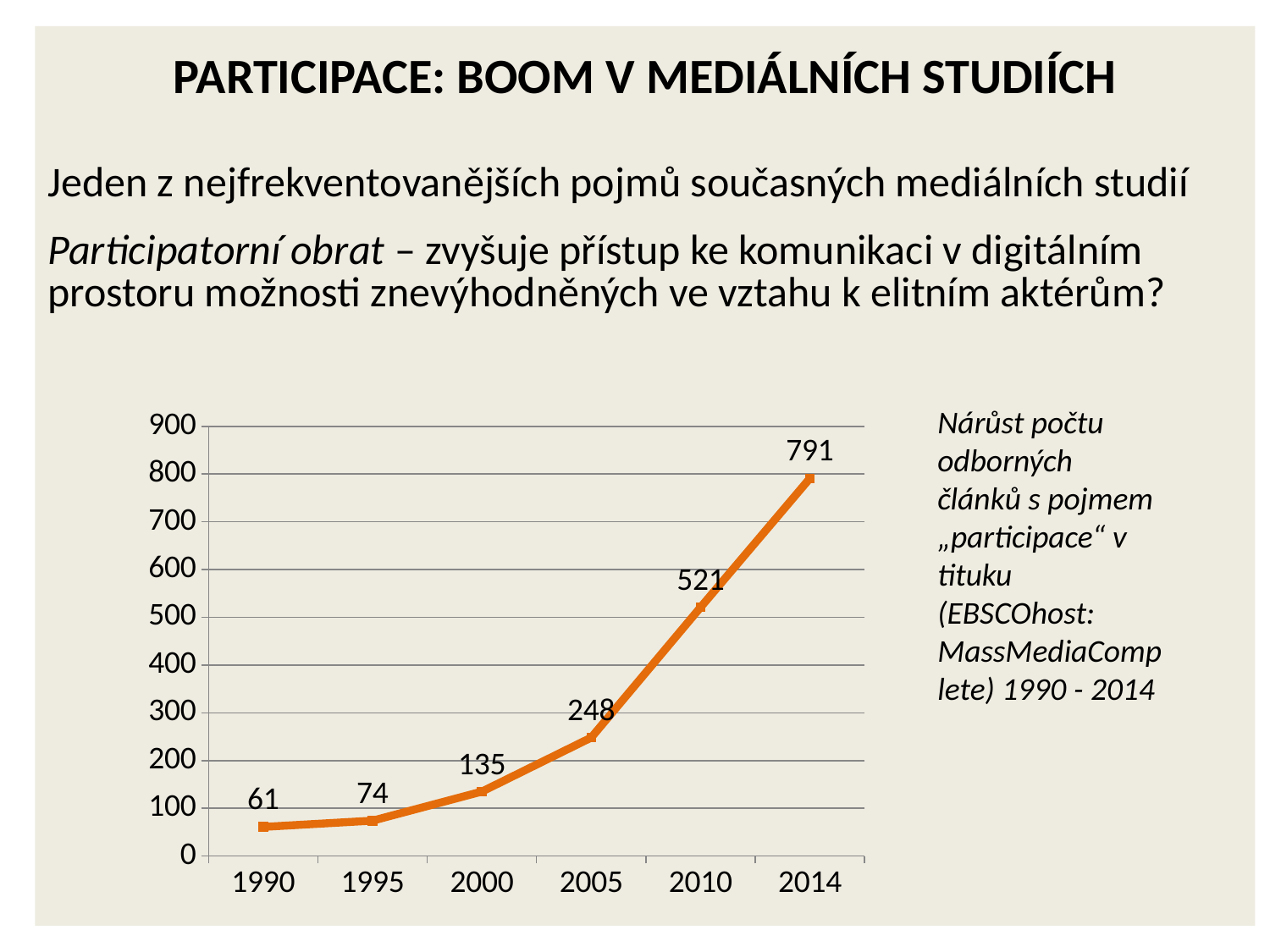
What kind of chart is shown on the slide? line chart Which year has the highest value? 2014 What is the difference between the values for 2000 and 1995? 61 Which is larger, the value for 2005 or the value for 2010? 2010 What is the value for 1990? 61 What is the difference between the values for 2014 and 2010? 270 How many data points are plotted on the chart? 6 Is the value for 2010 greater or less than 400? greater What is the value for 2005? 248 What is the value for 2014? 791 Which year has the lowest value? 1990 Do the values rise or fall from 1990 to 2014? rise